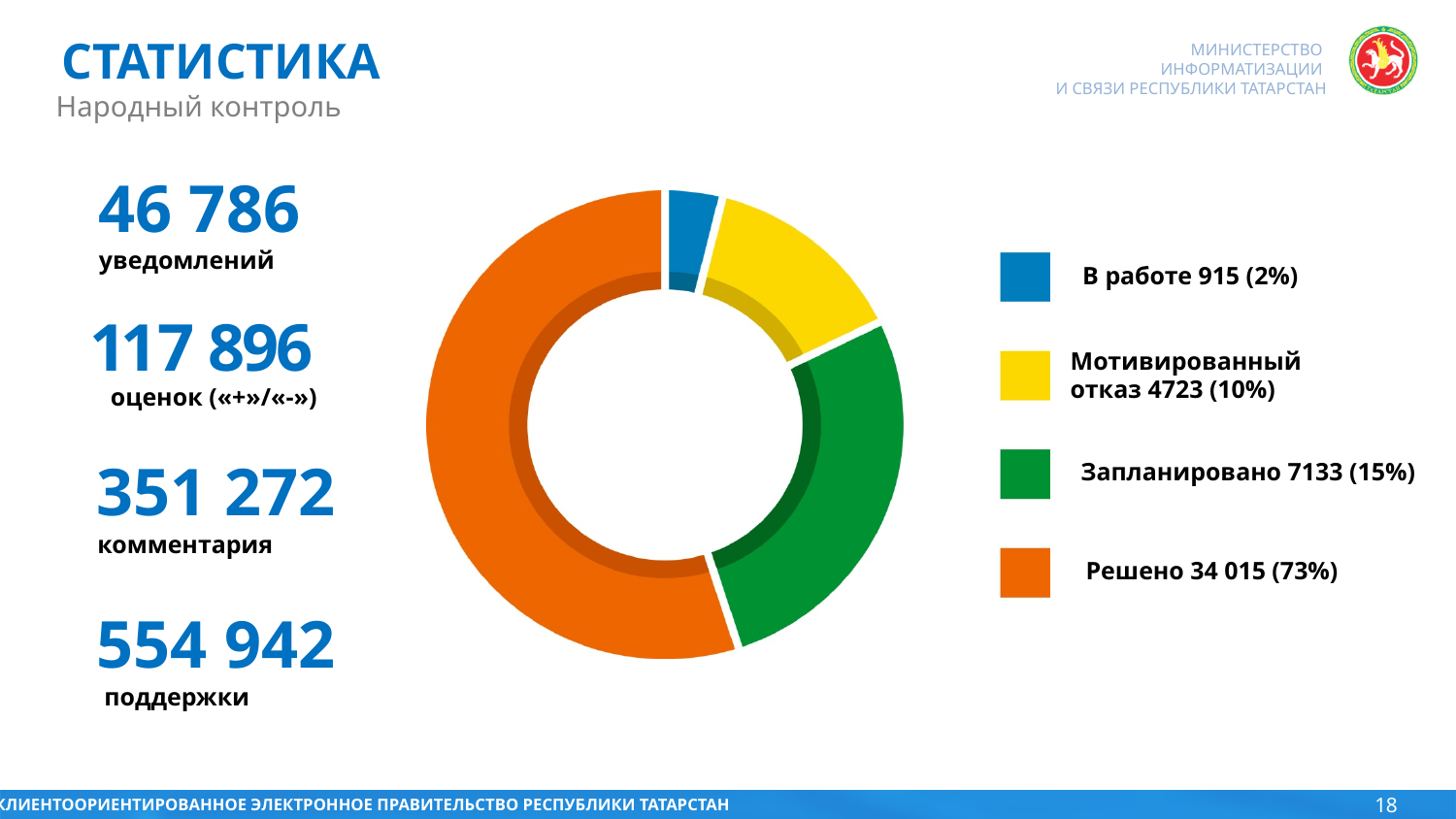
Which category has the smallest share of the donut chart? В работе How many categories does the donut chart show? 4 What is the value for «В работе» in the donut chart? 915 Which category has the largest share of the donut chart? Решено What is the difference between the values for «Запланировано» and «Мотивированный отказ»? 2410 What share of the donut chart does «Мотивированный отказ» represent? 10% What is the value for «Решено» in the donut chart? 34 015 What is the value for «Запланировано» in the donut chart? 7133 What share of the donut chart does «Запланировано» represent? 15% What is the value for «Мотивированный отказ» in the donut chart? 4723 Which is larger in the donut chart: «Мотивированный отказ» or «В работе»? Мотивированный отказ What kind of chart is shown on the slide? Pie chart (donut)